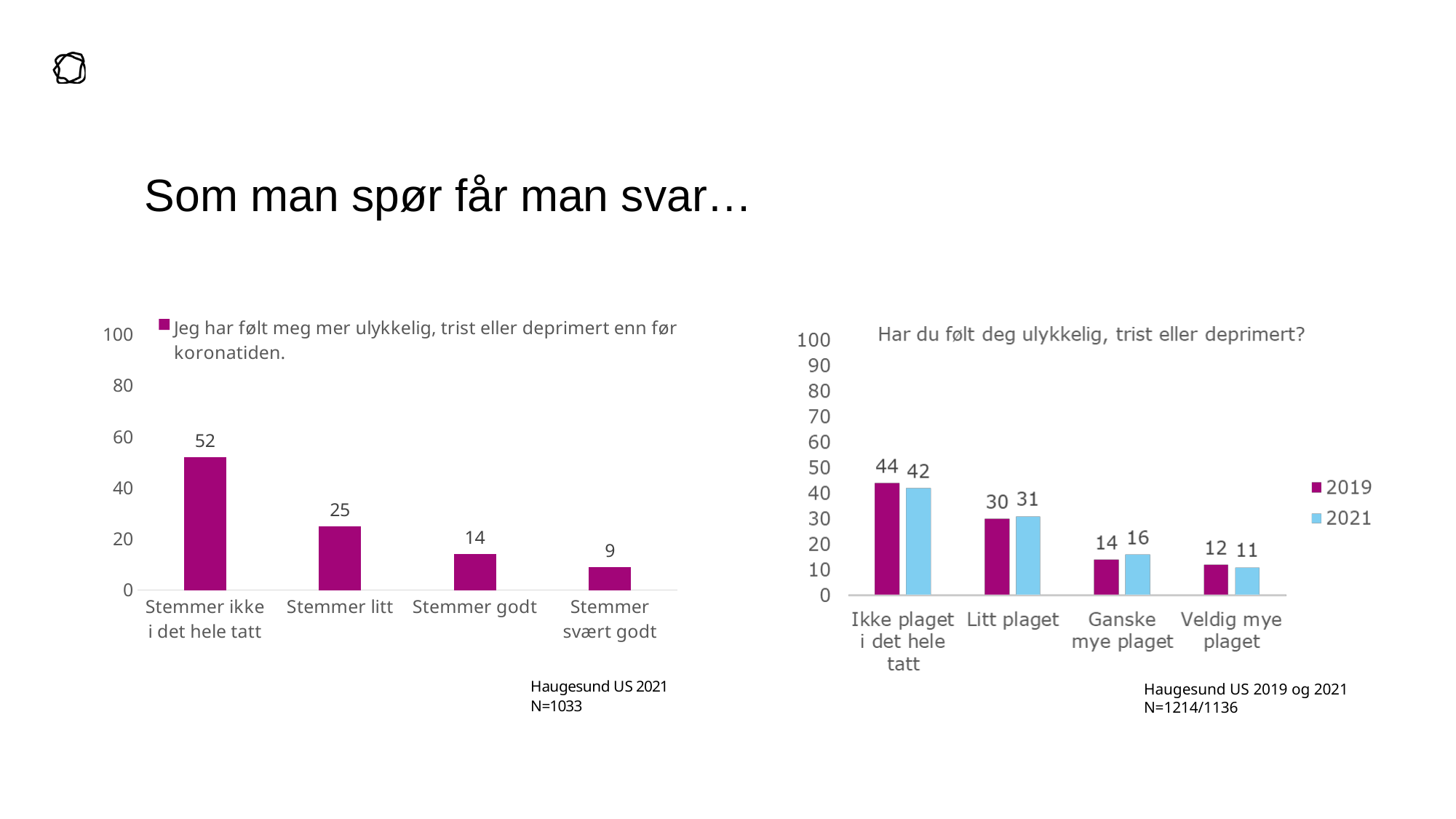
In the left chart, which category has the lowest value? Stemmer svært godt In the left chart, what is the value for 'Stemmer ikke i det hele tatt'? 52 In the right chart, which category has the highest 2019 value? Ikke plaget i det hele tatt In the right chart, what is the difference between the 2019 and 2021 values for 'Litt plaget'? 1 In the left chart, what is the difference between 'Stemmer ikke i det hele tatt' and 'Stemmer litt'? 27 In the right chart, what is the 2021 value for 'Ganske mye plaget'? 16 What kind of chart is the right chart? bar chart In the right chart, which is larger for 'Veldig mye plaget': the 2019 value or the 2021 value? 2019 In the right chart, how many series does the legend list? 2 In the left chart, how many categories are shown on the x axis? 4 In the left chart, do the values rise or fall from left to right along the x axis? fall In the right chart, what is the 2019 value for 'Ikke plaget i det hele tatt'? 44